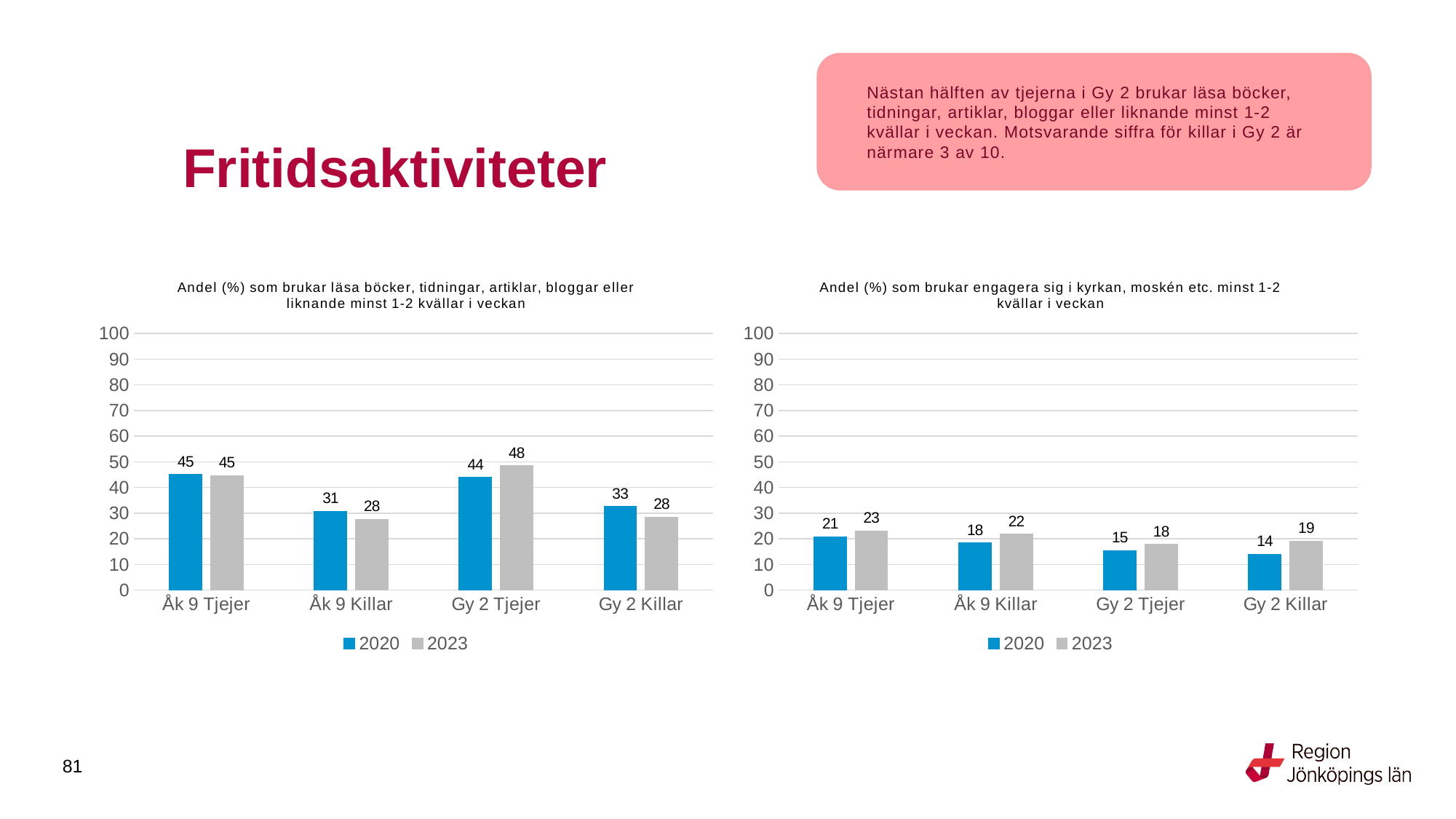
What kind of chart is the left chart? Bar chart How many series does the legend of the right chart list? 2 In the left chart (reading books, newspapers, articles, blogs), what is the value for Åk 9 Killar in 2020? 31 In the left chart (reading books, newspapers, articles, blogs), what is the difference between the 2020 and 2023 values for Gy 2 Killar? 5 In the right chart (engaging in church, mosque etc.), which is larger for Gy 2 Tjejer: the 2020 value or the 2023 value? 2023 How many categories are shown on the x axis of the left chart? 4 In the left chart (reading books, newspapers, articles, blogs), what is the value for Gy 2 Tjejer in 2023? 48 In the right chart (engaging in church, mosque etc.), what is the value for Gy 2 Killar in 2023? 19 In the right chart (engaging in church, mosque etc.), which category has the lowest value for 2020? Gy 2 Killar In the left chart (reading books, newspapers, articles, blogs), which category has the highest value for 2023? Gy 2 Tjejer In the right chart, which colour represents the 2020 series? Blue In the right chart (engaging in church, mosque etc.), what is the difference between the 2023 and 2020 values for Åk 9 Killar? 4